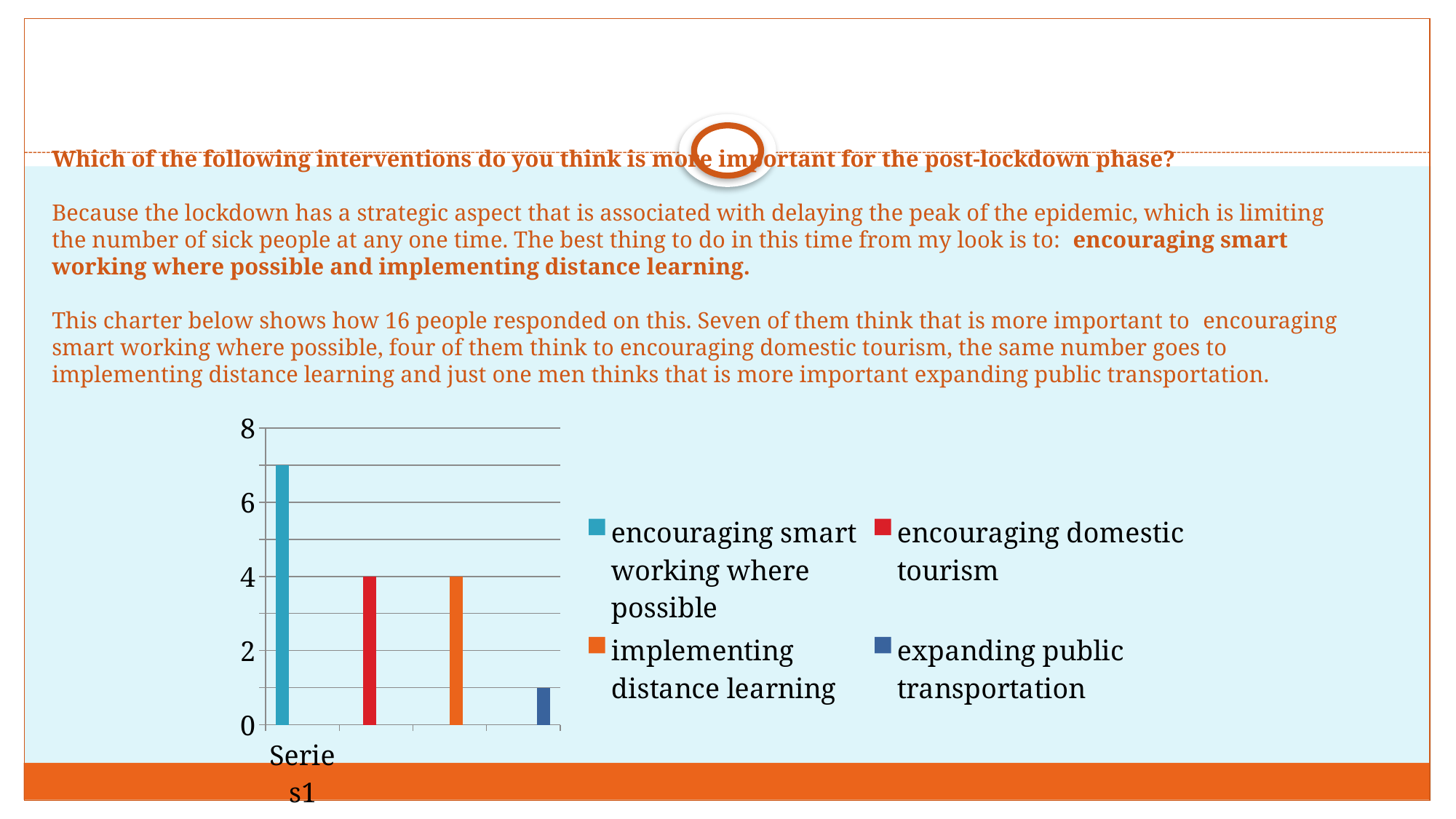
What is the value of the bar for encouraging domestic tourism? 4 Which series has the lowest bar in the chart? expanding public transportation What is the label shown on the x axis of the chart? Series1 What is the value of the bar for implementing distance learning? 4 What is the highest value shown on the chart's vertical axis? 8 What kind of chart is shown on the slide? bar chart Which series has the highest bar in the chart? encouraging smart working where possible Is the value for expanding public transportation greater or less than 2? less Which is larger: the bar for encouraging smart working where possible or the bar for encouraging domestic tourism? encouraging smart working where possible How many series does the chart legend list? 4 Is the value for encouraging smart working where possible greater or less than 6? greater Which is larger: the bar for implementing distance learning or the bar for expanding public transportation? implementing distance learning